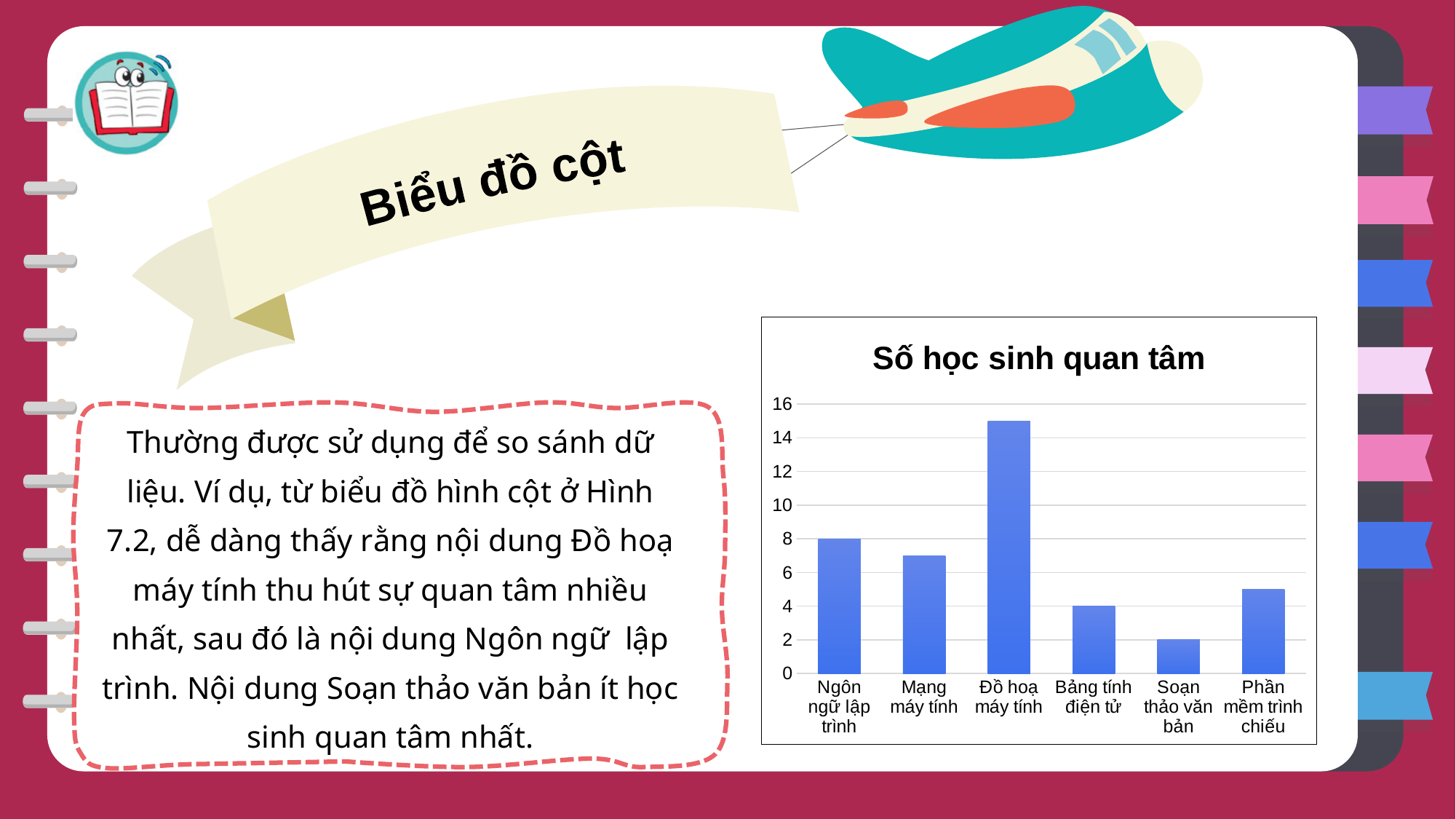
Which is larger, the value for Ngôn ngữ lập trình or the value for Soạn thảo văn bản? Ngôn ngữ lập trình What is the difference between the values for Ngôn ngữ lập trình and Bảng tính điện tử? 4 Which category has the highest value? Đồ hoạ máy tính How many categories are shown on the x axis of the chart? 6 What is the title of the chart? Số học sinh quan tâm Is the value for Phần mềm trình chiếu greater or less than 6? less What is the value for Soạn thảo văn bản? 2 Which category has the lowest value? Soạn thảo văn bản What is the value for Bảng tính điện tử? 4 What is the value for Ngôn ngữ lập trình? 8 What kind of chart is shown on the slide? bar chart Is the value for Đồ hoạ máy tính greater or less than 14? greater